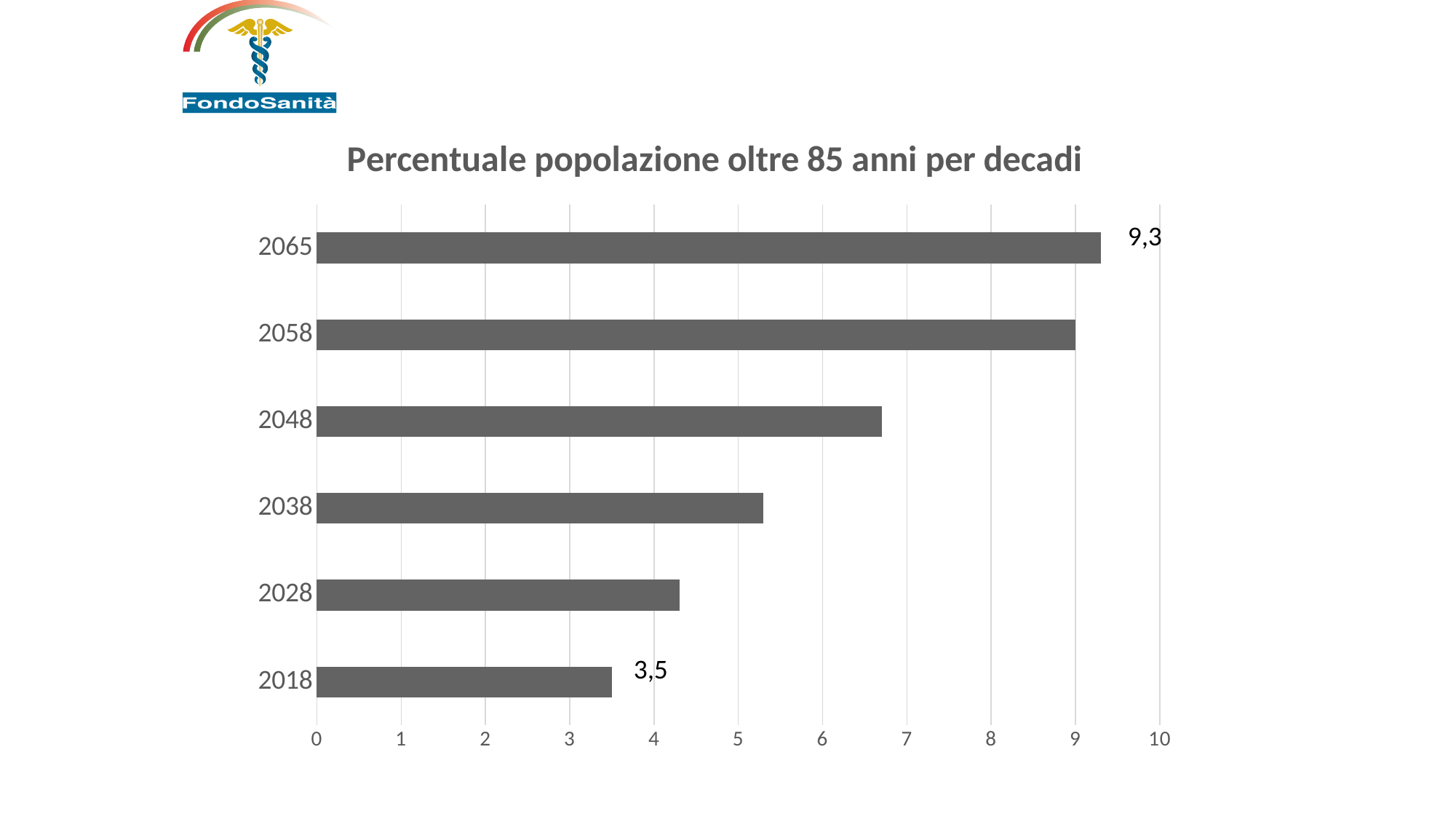
What is the title of the chart? Percentuale popolazione oltre 85 anni per decadi Which year has the highest value? 2065 What is the value for 2065? 9,3 What is the difference between the values for 2065 and 2018? 5,8 Which is larger, the value for 2048 or the value for 2028? 2048 What kind of chart is this? bar chart Is the value for 2048 greater or less than 6? greater Which year has the lowest value? 2018 What is the value for 2018? 3,5 Is the value for 2038 greater or less than 6? less How many years are shown on the chart? 6 Is the value for 2028 greater or less than 5? less